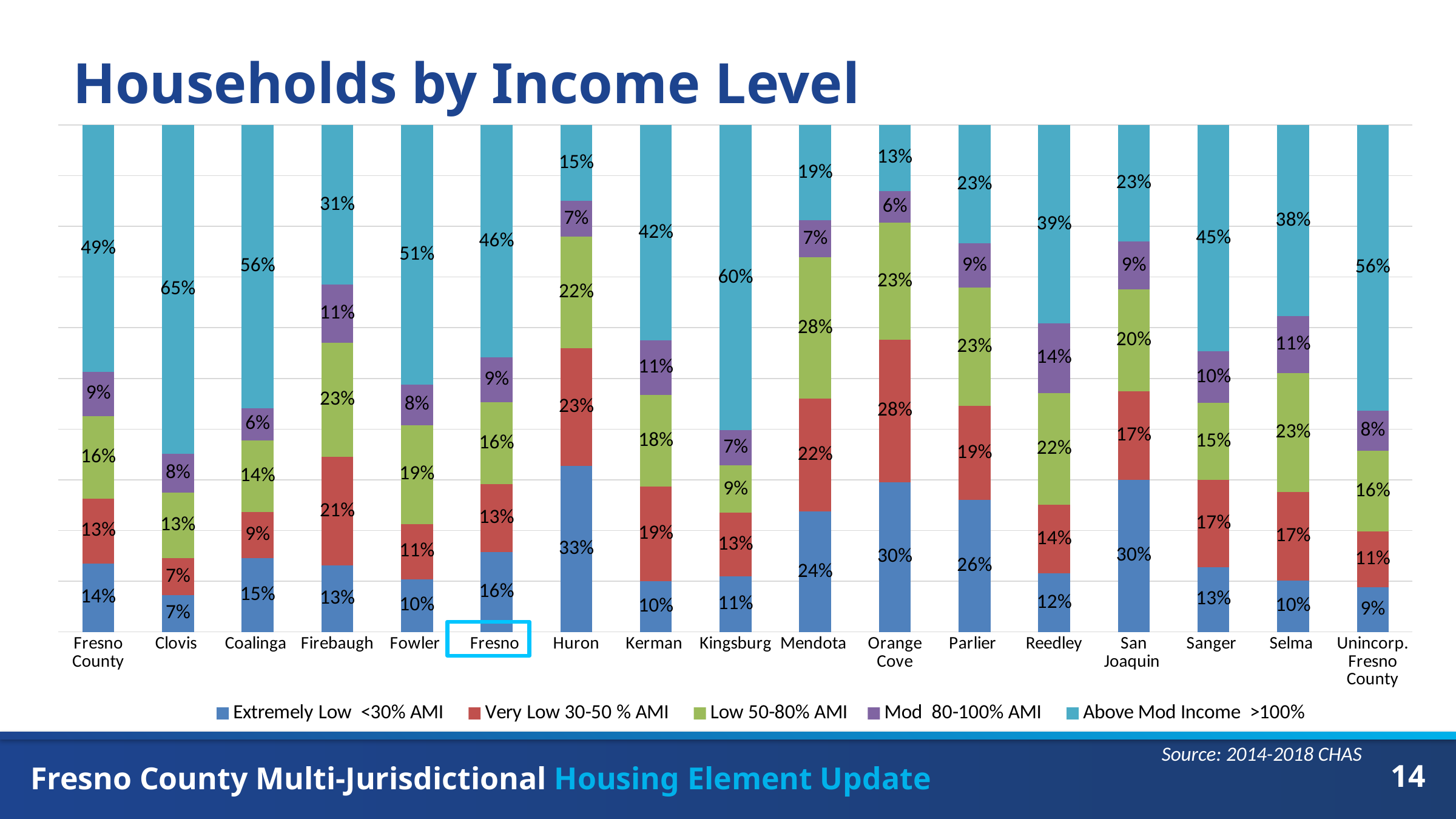
Which jurisdiction has the highest Above Mod Income >100% share? Clovis Which jurisdiction has the highest Extremely Low <30% AMI share? Huron What kind of chart is shown on the slide? Stacked bar chart What is the Extremely Low <30% AMI share for Fresno? 16% How many jurisdictions are shown on the x axis? 17 How many income-level series does the legend list? 5 Which jurisdiction has the lowest Above Mod Income >100% share? Orange Cove Which x-axis label is highlighted with a box on the slide? Fresno What percentage of Clovis households are in the Above Mod Income >100% category? 65% How many percentage points higher is the Very Low 30-50% AMI share in Firebaugh than in Fowler? 10 percentage points Which has a larger Low 50-80% AMI share, Mendota or Kerman? Mendota What is the Mod 80-100% AMI share for Reedley? 14%